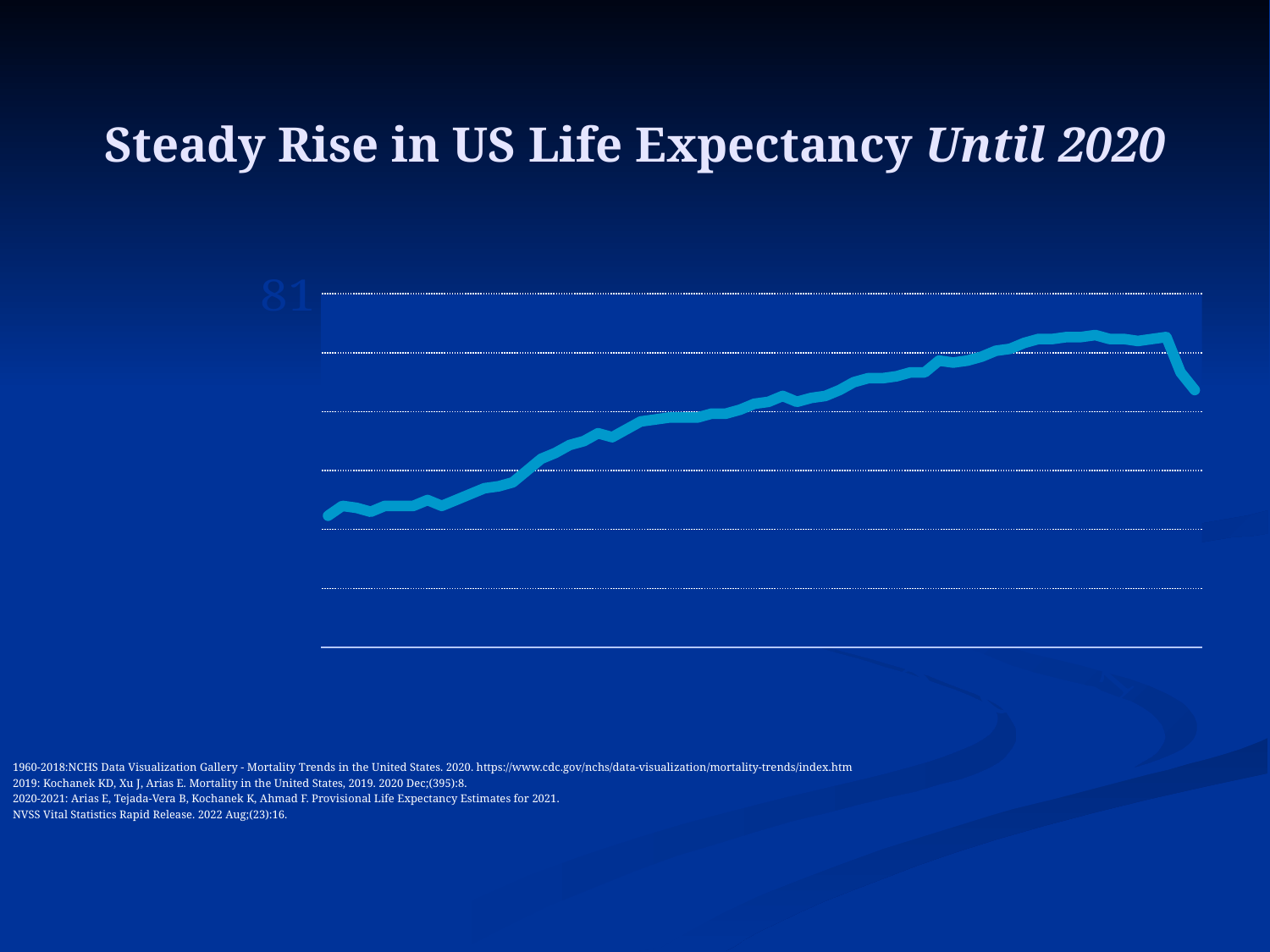
Do the values on the line generally rise or fall from left to right across most of the chart? rise At the far right end of the line, do the values rise or fall? fall What kind of chart is shown on the slide? line chart What is the title of the slide's chart? Steady Rise in US Life Expectancy Until 2020 Is the highest point on the line greater or less than 81? less How many lines are plotted on the chart? 1 What is the only value label shown on the vertical axis of the chart? 81